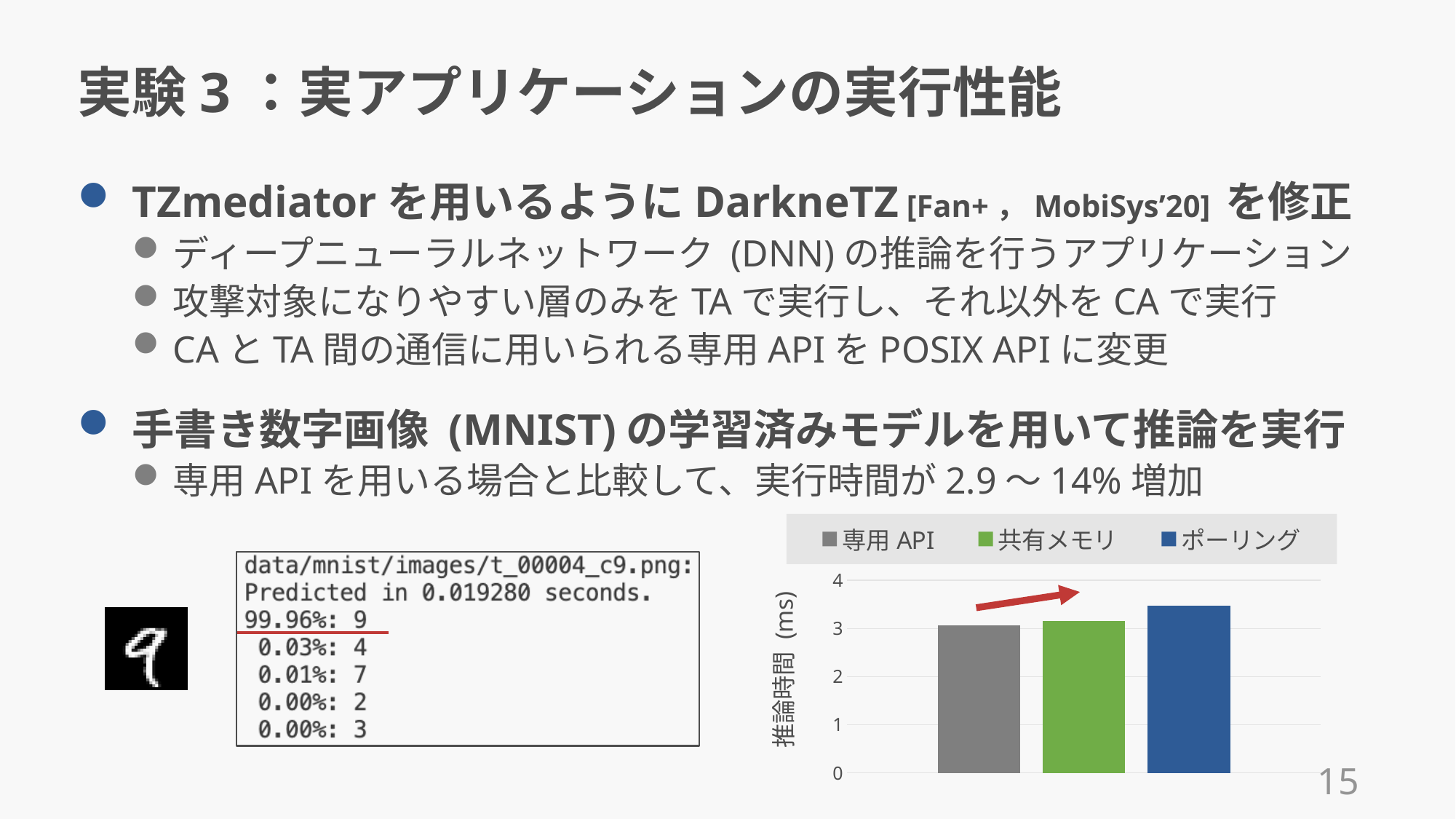
Is the value for 専用 API greater or less than 2? greater Which is larger in the chart, the value for ポーリング or the value for 共有メモリ? ポーリング How many series does the chart legend list? 3 Is the value for 共有メモリ greater or less than 4? less What colour is the bar for 共有メモリ in the chart? green How many bars are plotted in the chart? 3 What kind of chart is shown on the slide? bar chart What is the label of the chart's vertical axis? 推論時間 (ms) Which series has the highest inference time in the chart? ポーリング Which is larger in the chart, the value for ポーリング or the value for 専用 API? ポーリング Is the value for ポーリング greater or less than 3? greater